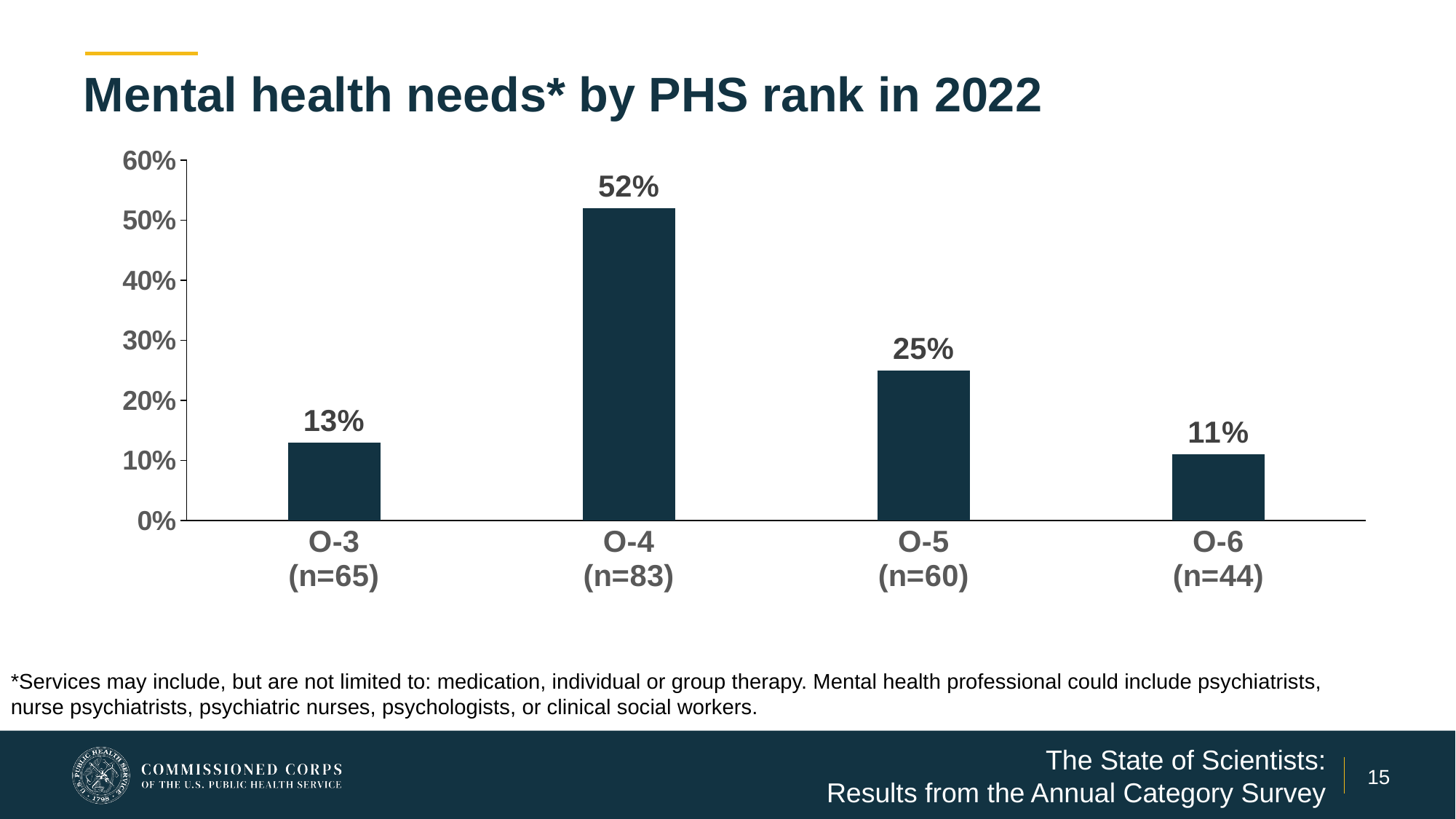
What is the value for O-4 (n=83)? 52% What is the title of the chart? Mental health needs* by PHS rank in 2022 Is the value for O-5 greater or less than 20%? greater What is the difference between the values for O-4 and O-5? 27% Which PHS rank has the highest value? O-4 (n=83) How many PHS rank categories are shown on the chart? 4 What kind of chart is shown on the slide? Bar chart What is the value for O-3 (n=65)? 13% What is the difference between the values for O-3 and O-6? 2% Which is larger, the value for O-5 or the value for O-3? O-5 Which PHS rank has the lowest value? O-6 (n=44) What is the value for O-6 (n=44)? 11%